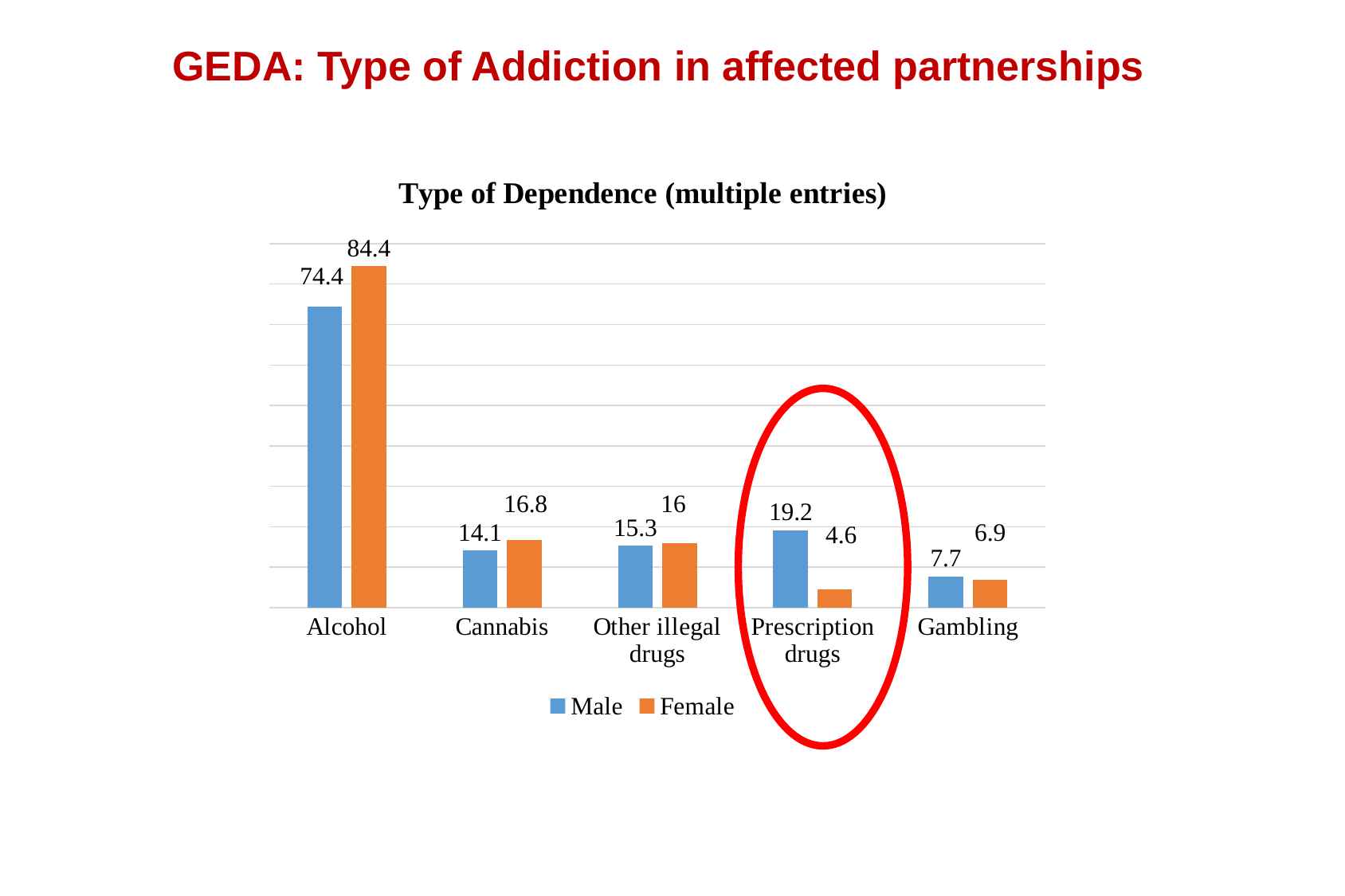
What is the Female value for Cannabis? 16.8 What is the Male value for Gambling? 7.7 Which category has the highest Female value? Alcohol What is the difference between the Male and Female values for Prescription drugs? 14.6 Which is larger for Prescription drugs, the Male value or the Female value? Male How many categories are shown on the x axis? 5 How many series does the legend list? 2 What is the Female value for Prescription drugs? 4.6 What is the Male value for Alcohol? 74.4 What kind of chart is shown on the slide? Bar chart Which category has the lowest Male value? Gambling What is the difference between the Female and Male values for Alcohol? 10